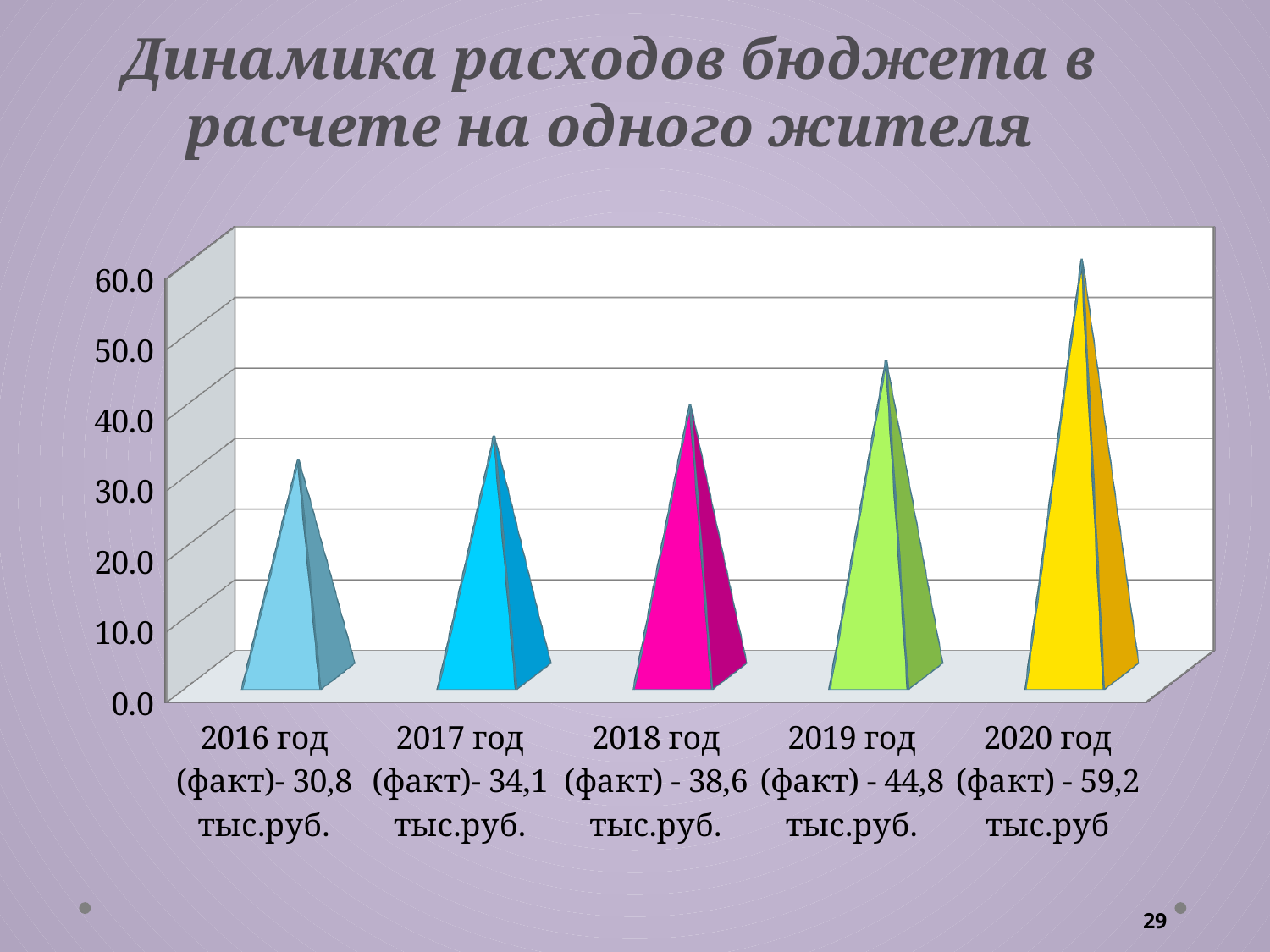
Which is larger, the value for 2018 or the value for 2019? 2019 How many years are shown on the chart? 5 What is the difference between the 2017 and 2016 values? 3,3 тыс.руб. Which year has the highest budget expenditure per resident? 2020 год Is the value for 2019 greater or less than 40.0? greater Which year has the lowest budget expenditure per resident? 2016 год What is the budget expenditure per resident for 2020 (факт)? 59,2 тыс.руб What kind of chart is shown on the slide? bar chart What is the budget expenditure per resident for 2016 (факт)? 30,8 тыс.руб. What is the budget expenditure per resident for 2018 (факт)? 38,6 тыс.руб. Do the values rise or fall from 2016 to 2020? rise What is the difference between the 2020 and 2019 values? 14,4 тыс.руб.